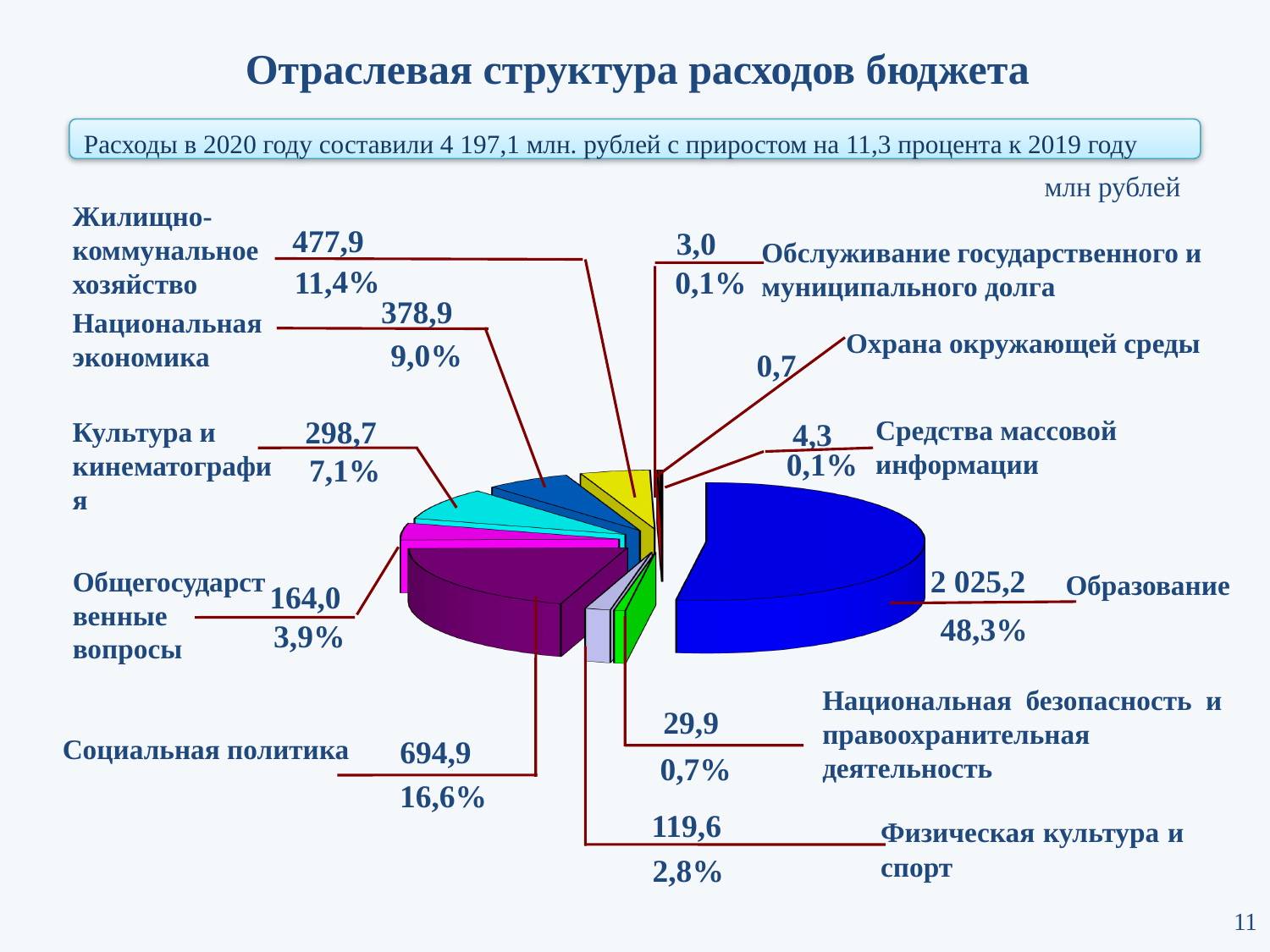
What is the title of the slide's chart? Отраслевая структура расходов бюджета Which is larger: the value for Культура и кинематография or the value for Общегосударственные вопросы? Культура и кинематография Which category has the largest share of the pie? Образование What is the value for Образование in млн рублей? 2 025,2 What type of chart is shown on the slide? pie chart What is the value for Физическая культура и спорт? 119,6 What is the difference between the values for Социальная политика and Жилищно-коммунальное хозяйство? 217,0 What share of the pie does Национальная экономика represent? 9,0% Which category has the smallest value? Охрана окружающей среды How many categories are shown in the pie chart? 11 What is the value for Жилищно-коммунальное хозяйство? 477,9 What share of the pie does Социальная политика represent? 16,6%